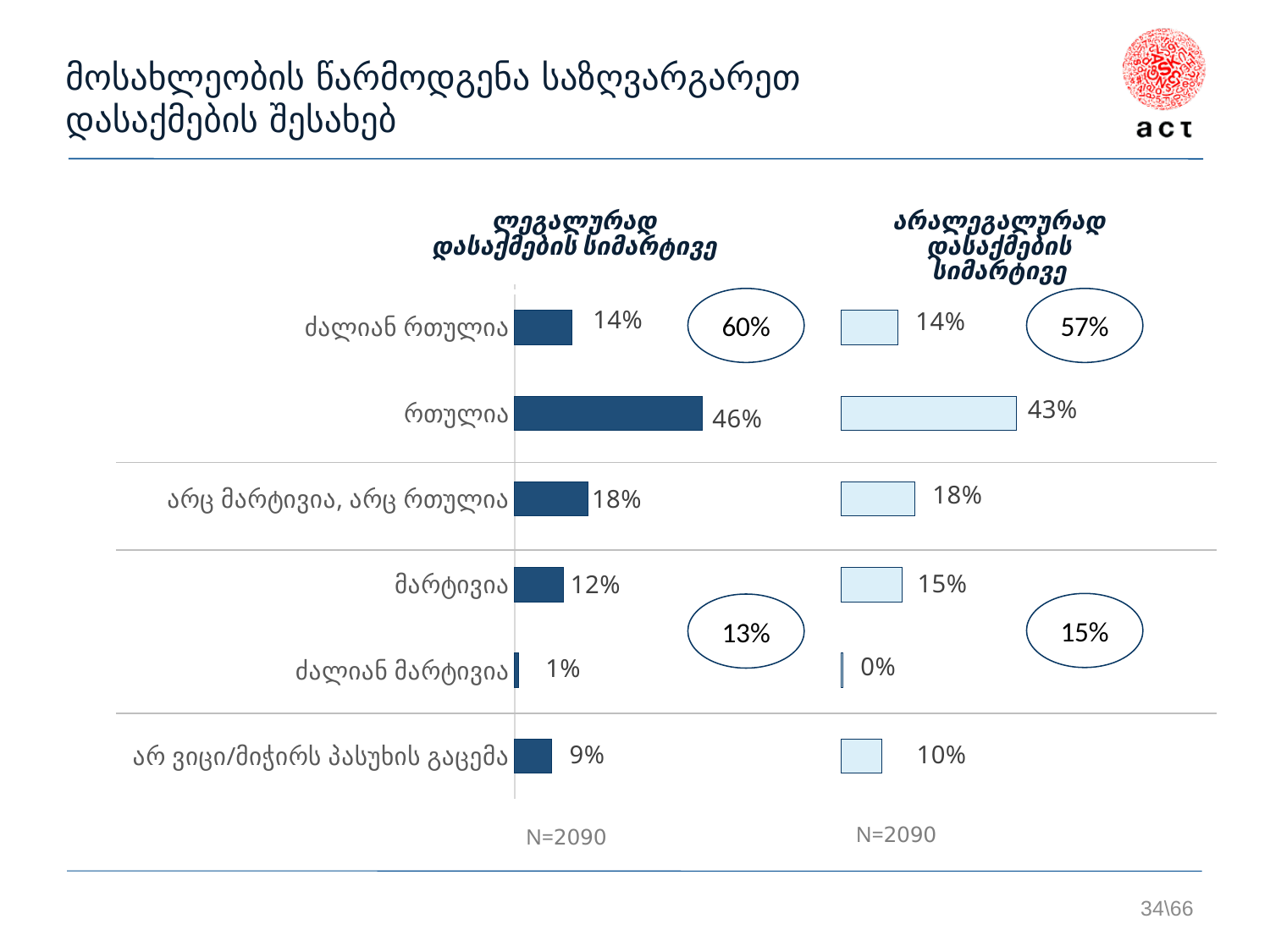
In the left chart (ლეგალურად დასაქმების სიმარტივე), what is the difference between რთულია and ძალიან რთულია? 32% What type of chart is used on this slide? Bar chart Which is larger: მარტივია in the left chart or მარტივია in the right chart? Right chart (15%) How many categories are shown in the left chart (ლეგალურად დასაქმების სიმარტივე)? 6 What sample size (N) is shown under the left chart? N=2090 In the right chart (არალეგალურად დასაქმების სიმარტივე), what is the value for მარტივია? 15% In the right chart (არალეგალურად დასაქმების სიმარტივე), what is the value for არ ვიცი/მიჭირს პასუხის გაცემა? 10% In the left chart (ლეგალურად დასაქმების სიმარტივე), which category has the highest value? რთულია In the right chart (არალეგალურად დასაქმების სიმარტივე), which category has the lowest value? ძალიან მარტივია In the left chart (ლეგალურად დასაქმების სიმარტივე), what is the value for ძალიან მარტივია? 1% What is the difference between the რთულია values in the left chart and the right chart? 3% In the left chart (ლეგალურად დასაქმების სიმარტივე), what is the value for რთულია? 46%